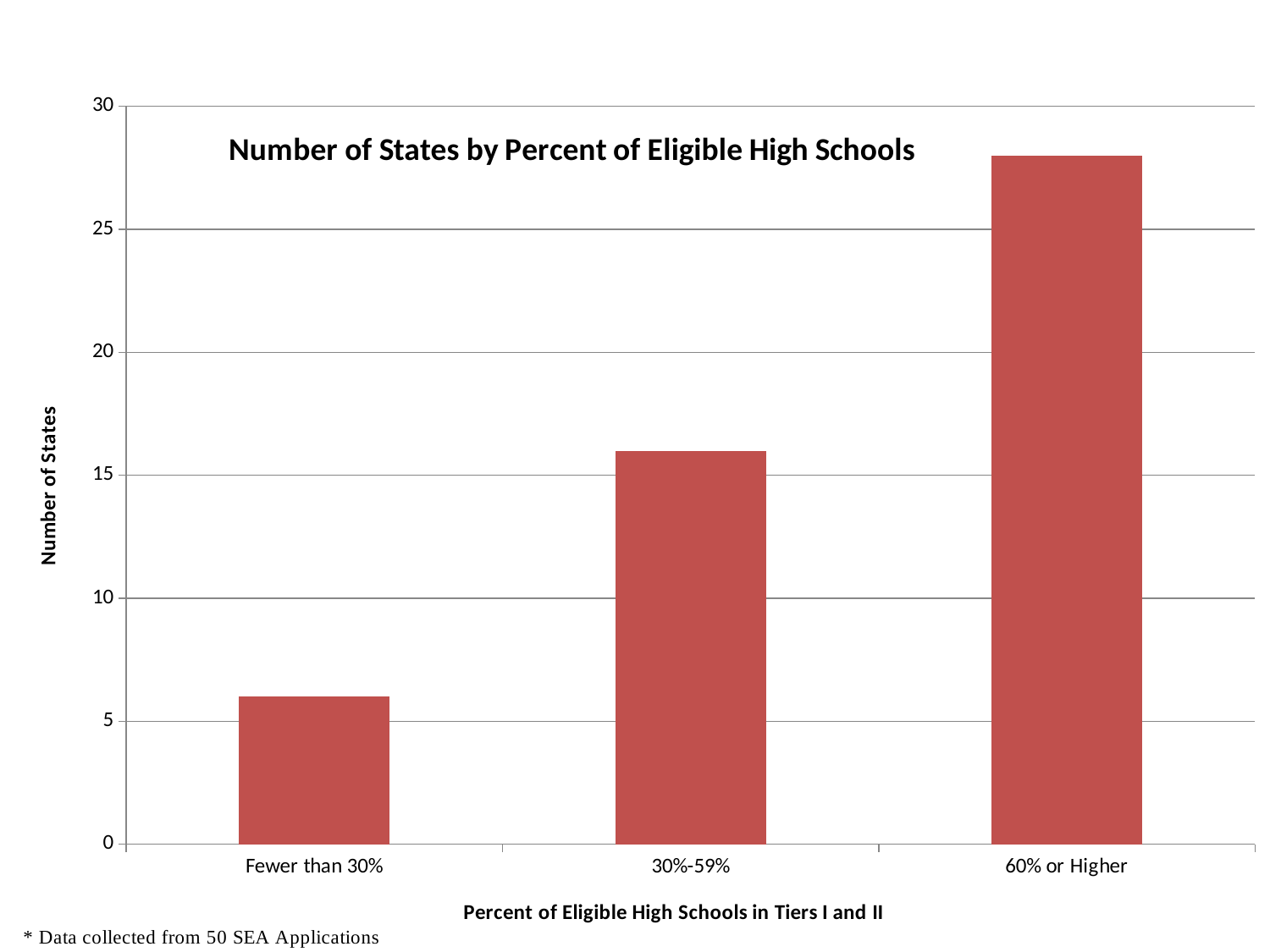
Is the number of states for Fewer than 30% greater or less than 10? less Is the number of states for 60% or Higher greater or less than 25? greater What is the title of the chart? Number of States by Percent of Eligible High Schools How many categories are shown on the x axis? 3 Which category has the lowest number of states? Fewer than 30% What kind of chart is shown on the slide? bar chart What is the label of the x axis? Percent of Eligible High Schools in Tiers I and II Do the values rise or fall moving from left to right along the x axis? rise Which category has the highest number of states? 60% or Higher Is the number of states for 30%-59% greater or less than 20? less Which has more states, 30%-59% or Fewer than 30%? 30%-59%